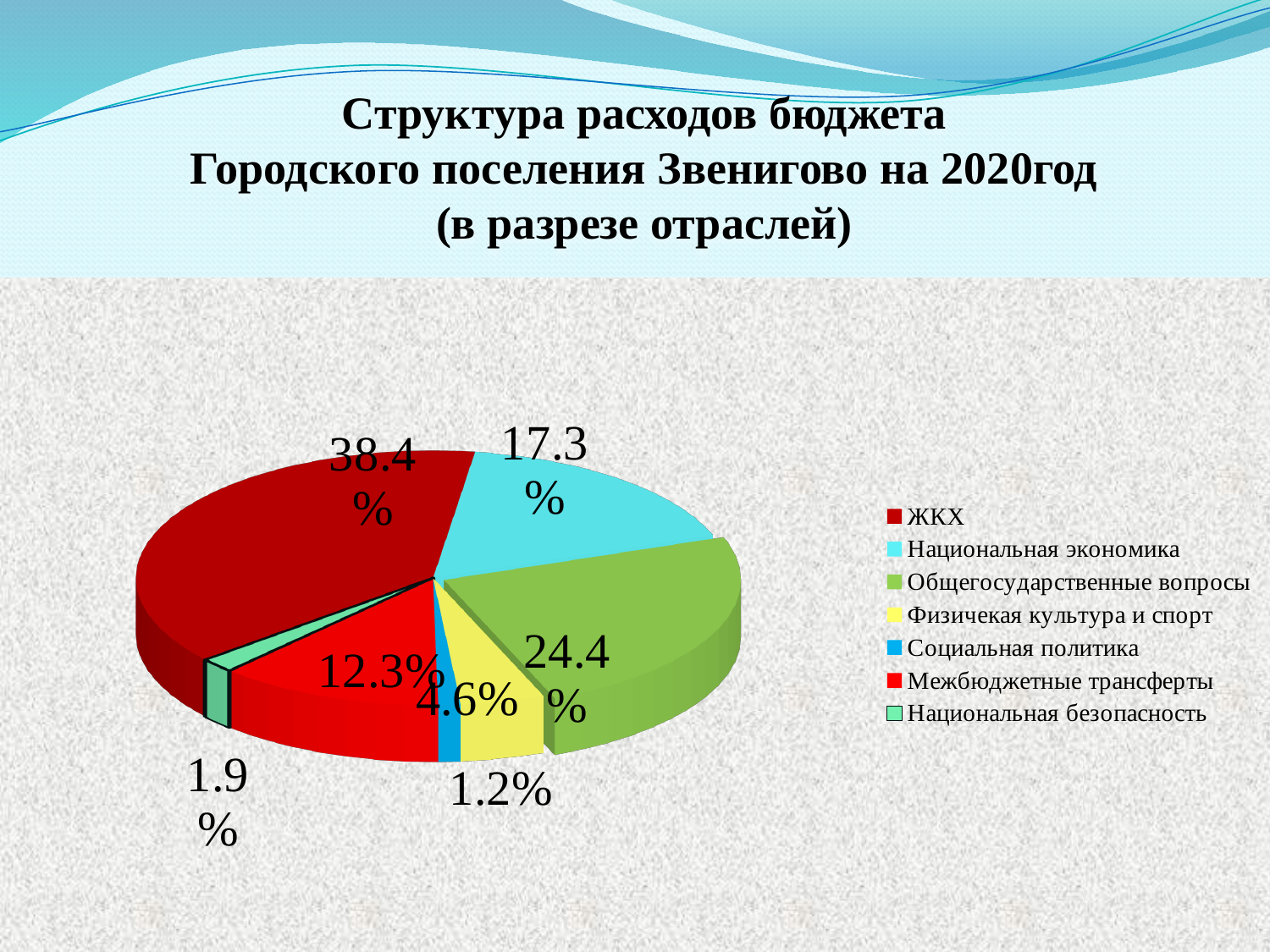
What type of chart is shown on the slide? pie chart What is the difference in percentage points between the shares of ЖКХ and Общегосударственные вопросы? 14 percentage points Which has a larger share: Физичекая культура и спорт or Национальная безопасность? Физичекая культура и спорт What share of budget expenditure is allocated to ЖКХ? 38.4% What share of budget expenditure is allocated to Социальная политика? 1.2% Which category has the smallest share of the budget expenditure? Социальная политика Which category has the largest share of the budget expenditure? ЖКХ How many categories does the legend list? 7 What share of budget expenditure is allocated to Общегосударственные вопросы? 24.4% Which colour represents Национальная экономика in the pie chart? cyan (light blue) What share of budget expenditure is allocated to Межбюджетные трансферты? 12.3% What share of budget expenditure is allocated to Национальная экономика? 17.3%